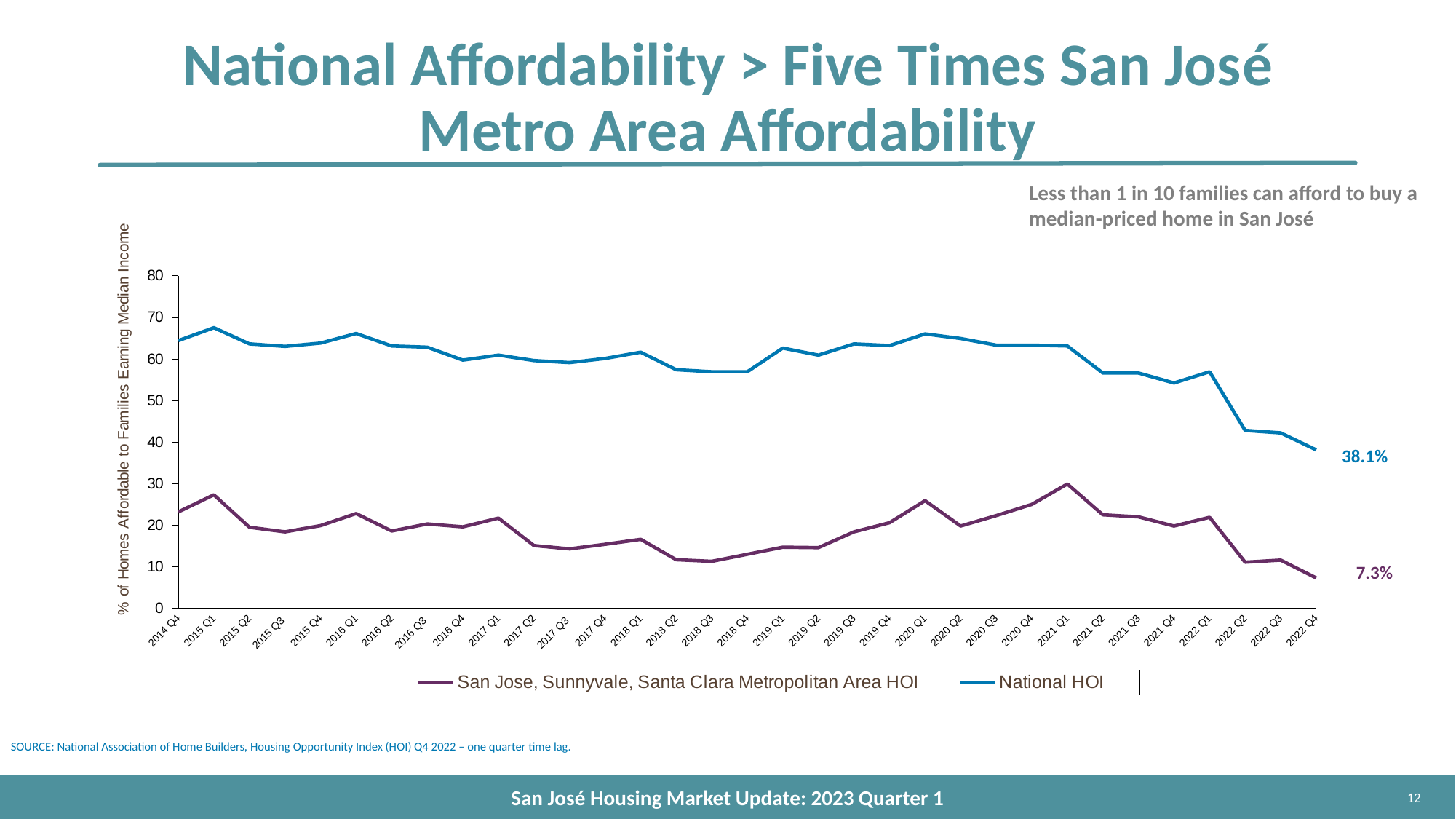
Is the National HOI value for 2015 Q1 greater or less than 60? greater Does the National HOI rise or fall from 2021 Q1 to 2022 Q4? Fall In 2022 Q4, which series has the larger value: National HOI or San Jose, Sunnyvale, Santa Clara Metropolitan Area HOI? National HOI What is the difference between the National HOI and the San Jose Metropolitan Area HOI in 2022 Q4? 30.8 percentage points In which quarter does the San Jose, Sunnyvale, Santa Clara Metropolitan Area HOI reach its highest value? 2021 Q1 How many series does the legend list? 2 What is the National HOI value for 2022 Q4? 38.1% How many quarters are plotted along the x axis? 33 What kind of chart is shown on the slide? Line chart What is the San Jose, Sunnyvale, Santa Clara Metropolitan Area HOI value for 2022 Q4? 7.3% What is the label on the y axis of the chart? % of Homes Affordable to Families Earning Median Income Is the San Jose, Sunnyvale, Santa Clara Metropolitan Area HOI value for 2018 Q3 greater or less than 20? less